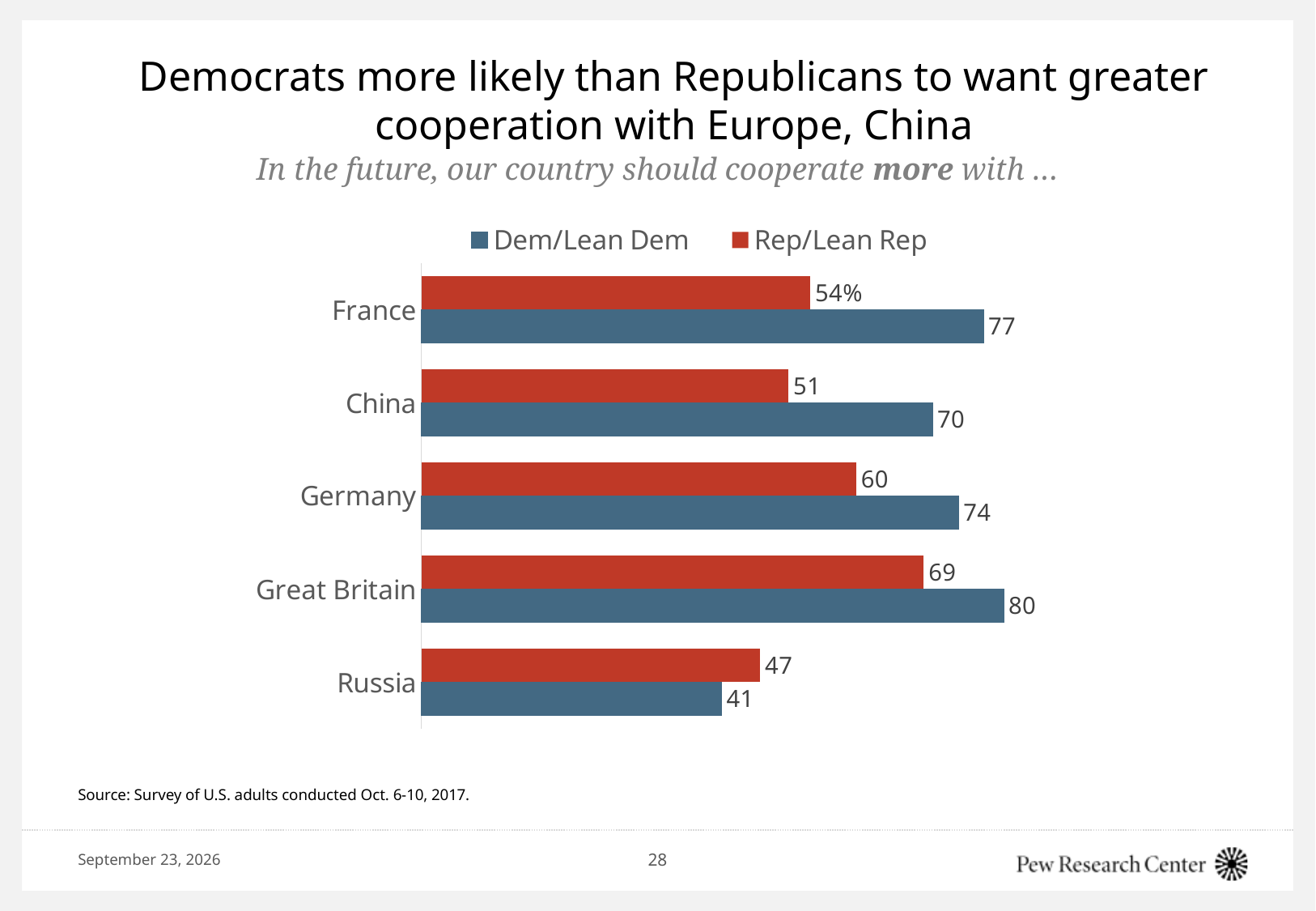
What kind of chart is shown on the slide? Bar chart Which country has the lowest Rep/Lean Rep value? Russia What colour represents Rep/Lean Rep in the chart? Red What percentage of Dem/Lean Dem say the country should cooperate more with France? 77 What is the Rep/Lean Rep value for France? 54% For Russia, which is larger: the Dem/Lean Dem value or the Rep/Lean Rep value? Rep/Lean Rep What is the Rep/Lean Rep value for Germany? 60 How many series does the legend list? 2 What is the difference between the Dem/Lean Dem and Rep/Lean Rep values for China? 19 Which country has the highest Dem/Lean Dem value? Great Britain What is the difference between the Dem/Lean Dem values for Great Britain and Russia? 39 How many countries are shown in the chart? 5